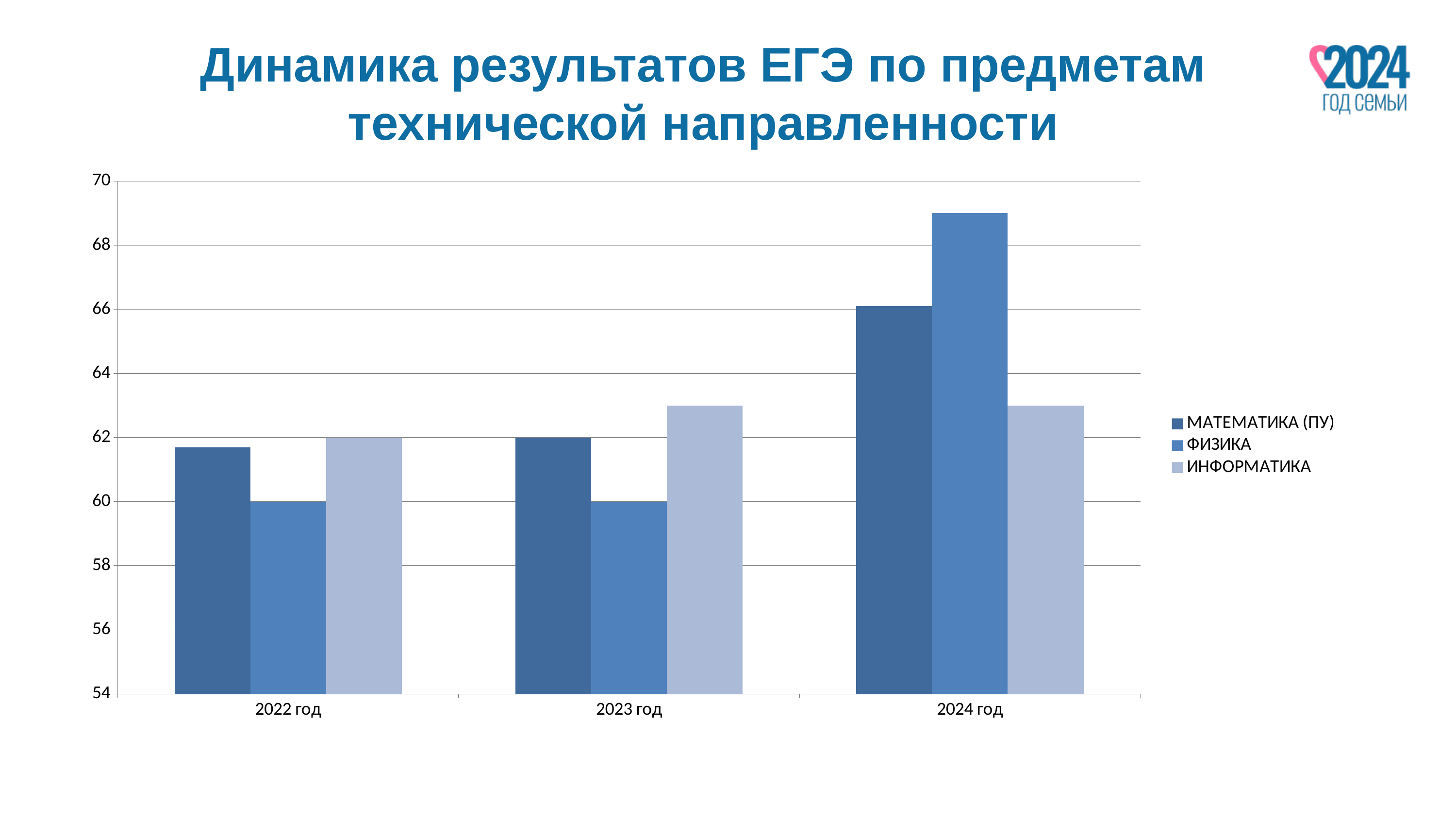
Is the value for ФИЗИКА in 2024 год greater or less than 68? greater Which series has the highest value in 2024 год? ФИЗИКА What is the value for ИНФОРМАТИКА in 2022 год? 62 What is the value for ФИЗИКА in 2022 год? 60 What kind of chart is shown on the slide? bar chart How many year categories are shown on the x axis? 3 What is the value for МАТЕМАТИКА (ПУ) in 2023 год? 62 How many series does the legend list? 3 Which series has the lowest value in 2023 год? ФИЗИКА Is the value for ИНФОРМАТИКА in 2024 год greater or less than 64? less Does the value for МАТЕМАТИКА (ПУ) rise or fall from 2022 год to 2024 год? rise